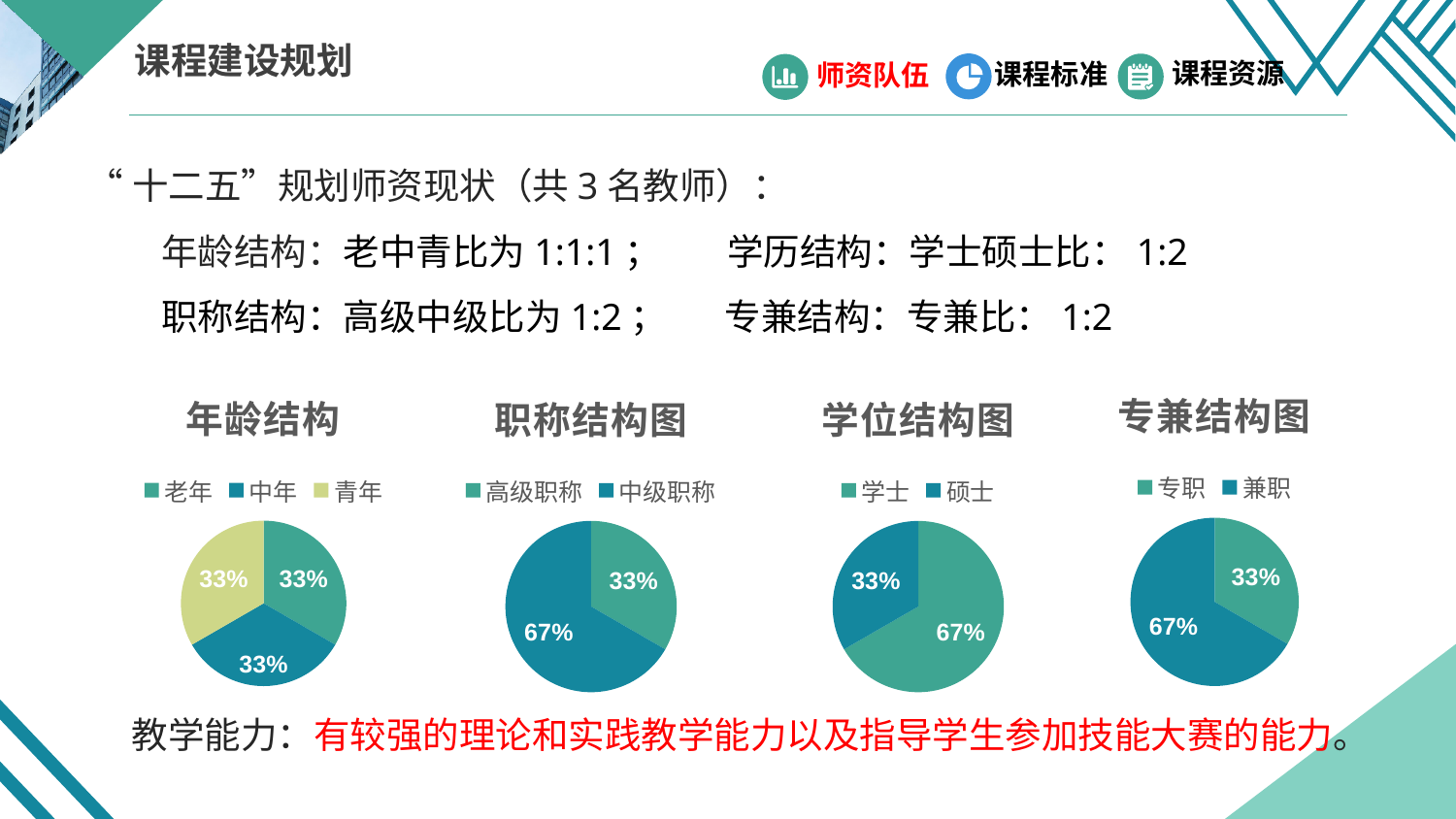
In the 专兼结构图 chart, what is the value for 兼职? 67% In the 职称结构图 chart, what is the difference between 中级职称 and 高级职称? 34% In the 职称结构图 chart, what is the value for 中级职称? 67% In the 专兼结构图 chart, which category has the smallest share? 专职 What type of chart is the 年龄结构 chart? pie chart How many pie charts are shown on the slide? 4 How many slices does the 年龄结构 pie chart have? 3 In the 年龄结构 chart, what is the value for 中年? 33% In the 职称结构图 chart, which category has the largest share? 中级职称 In the 学位结构图 chart, what is the value for 硕士? 33% How many entries does the legend of the 年龄结构 chart list? 3 In the 学位结构图 chart, which is larger, 学士 or 硕士? 学士